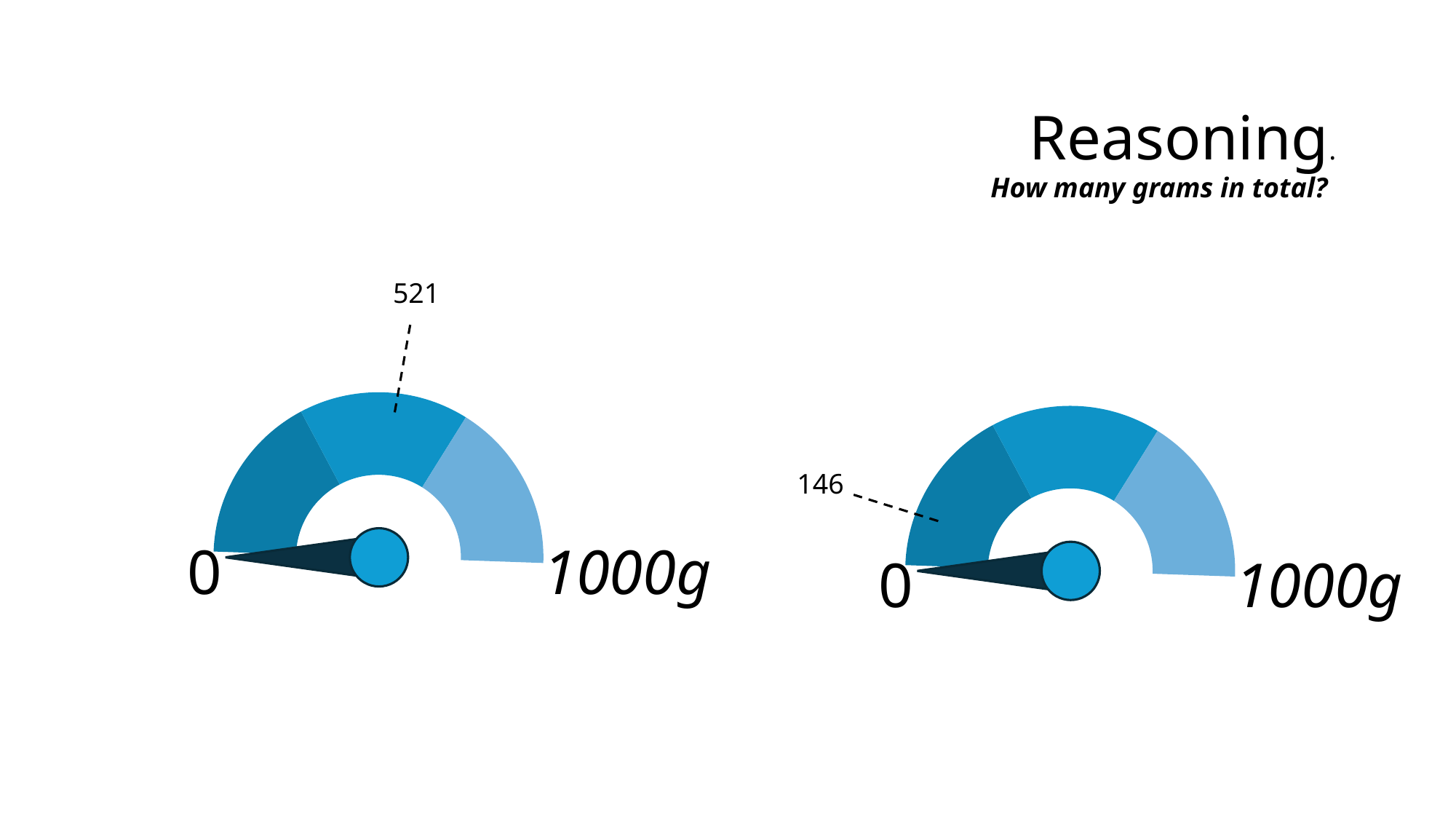
How many coloured segments does each gauge arc have? 3 Which gauge shows the larger labelled value, the left or the right? left Is the value labelled on the right gauge greater or less than 500? less What kind of chart is shown on the slide? gauge chart What is the difference between the left gauge's value (521) and the right gauge's value (146)? 375 On the right gauge, what value is shown by the data label? 146 What is the total of the values labelled on the two gauges? 667 On the left gauge, what value is shown by the data label? 521 Is the value labelled on the left gauge greater or less than 500? greater How many gauge charts are on the slide? 2 What is the maximum value shown on the scale of each gauge? 1000g What is the minimum value shown on the scale of each gauge? 0